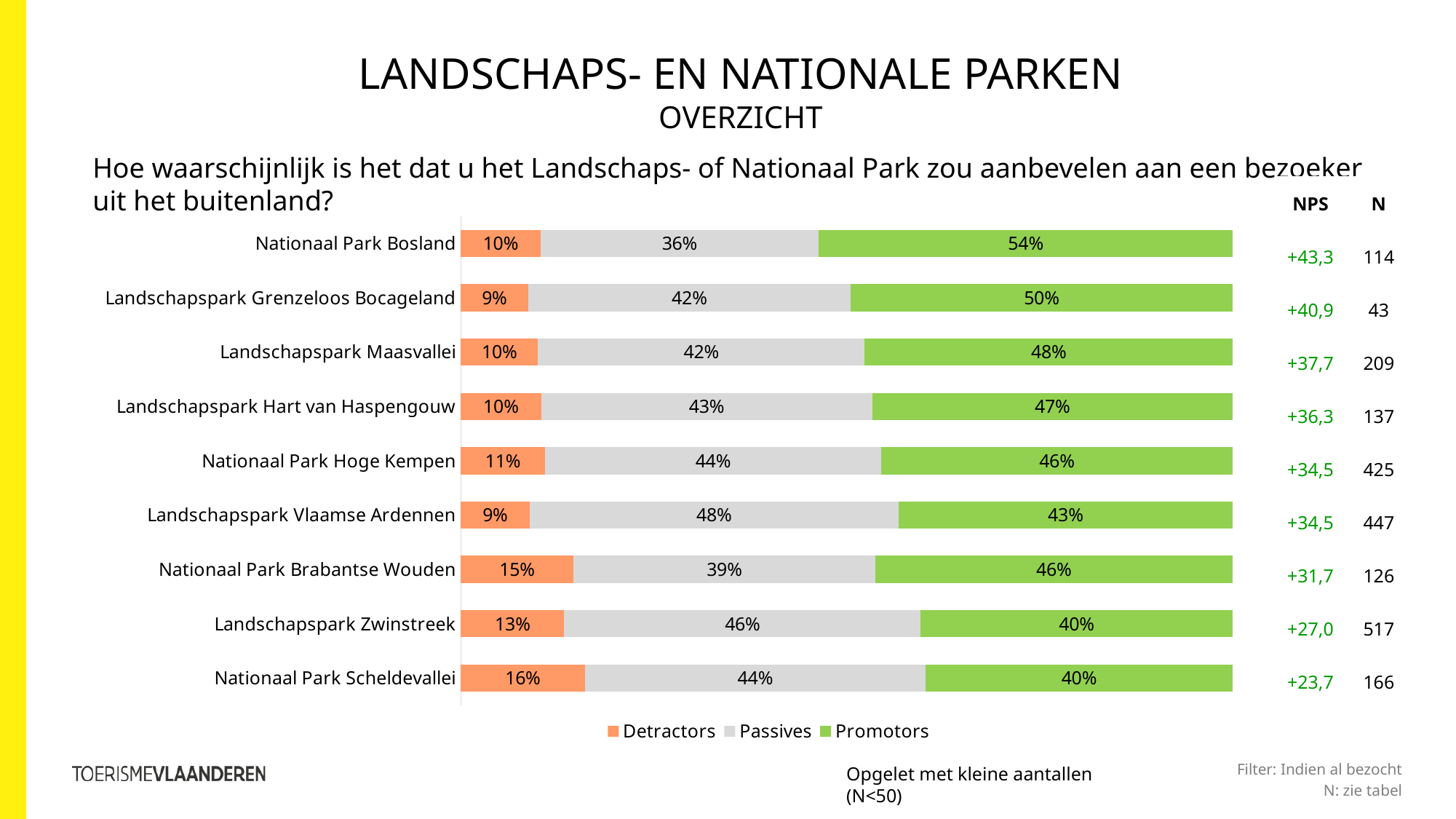
What is the total of the stacked bar for Landschapspark Maasvallei? 100% Which park has the highest Promotors percentage? Nationaal Park Bosland Which has a larger Detractors percentage, Nationaal Park Brabantse Wouden or Landschapspark Zwinstreek? Nationaal Park Brabantse Wouden What is the difference between the Promotors percentages of Nationaal Park Bosland and Nationaal Park Scheldevallei? 14% Which park has the lowest Passives percentage? Nationaal Park Bosland How many series does the legend list? 3 What is the Detractors value for Nationaal Park Scheldevallei? 16% What kind of chart is shown on the slide? Stacked bar chart How many parks are shown in the chart? 9 Which colour represents Promotors in the chart? Green What percentage of Promotors does Nationaal Park Bosland have? 54% What is the Passives value for Landschapspark Vlaamse Ardennen? 48%